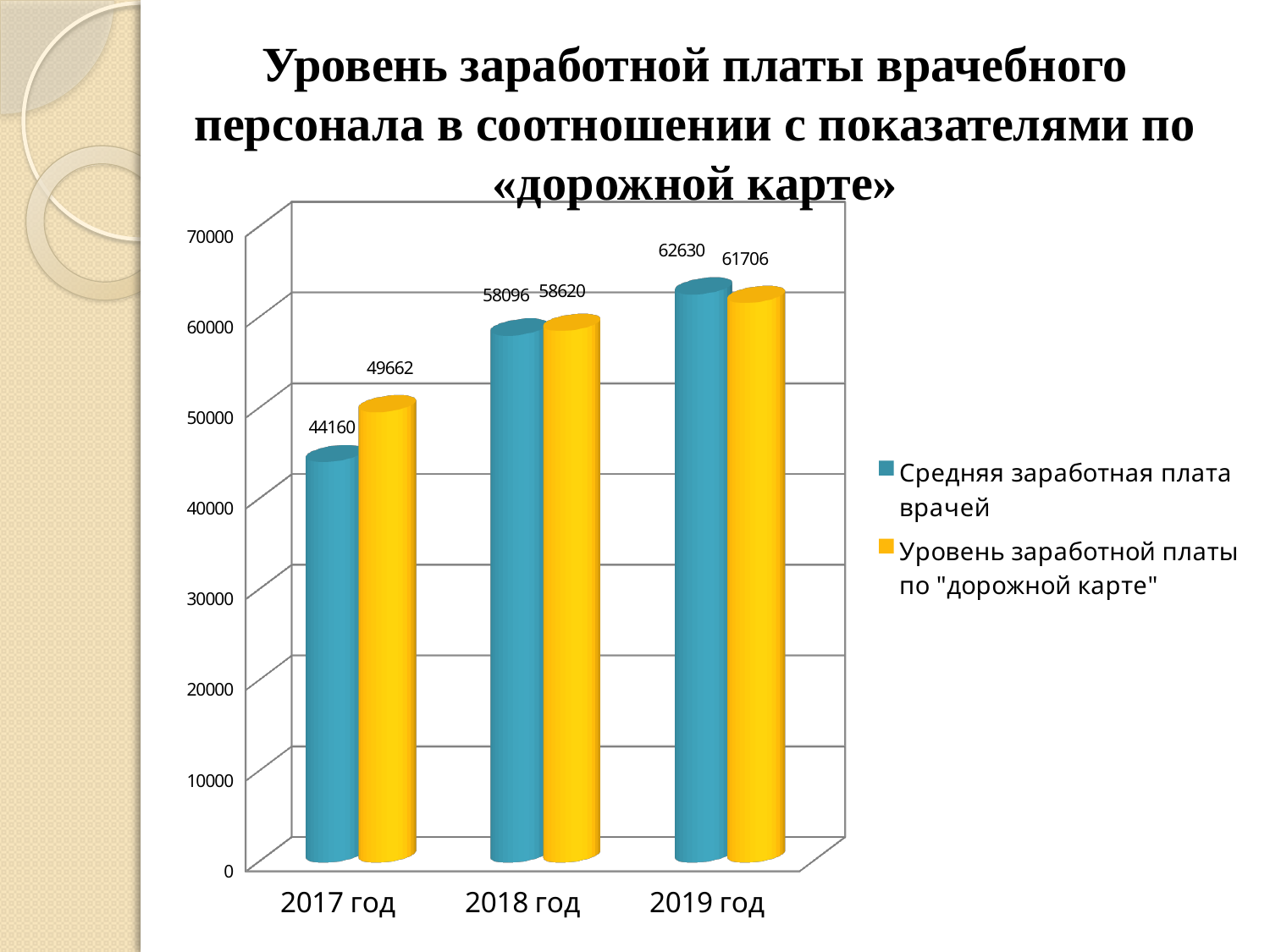
What is the value of 'Уровень заработной платы по "дорожной карте"' for 2019 год? 61706 In which year is 'Средняя заработная плата врачей' highest? 2019 год What kind of chart is shown on the slide? bar chart Is the value of 'Средняя заработная плата врачей' for 2018 год greater or less than 50000? greater What is the difference between 'Уровень заработной платы по "дорожной карте"' and 'Средняя заработная плата врачей' in 2017 год? 5502 Does 'Средняя заработная плата врачей' rise or fall from 2017 год to 2019 год? rise What is the value of 'Уровень заработной платы по "дорожной карте"' for 2018 год? 58620 How many series does the legend list? 2 What is the value of 'Средняя заработная плата врачей' for 2017 год? 44160 Which is larger in 2019 год: 'Средняя заработная плата врачей' or 'Уровень заработной платы по "дорожной карте"'? Средняя заработная плата врачей How many years are shown on the x axis? 3 In which year is 'Уровень заработной платы по "дорожной карте"' lowest? 2017 год